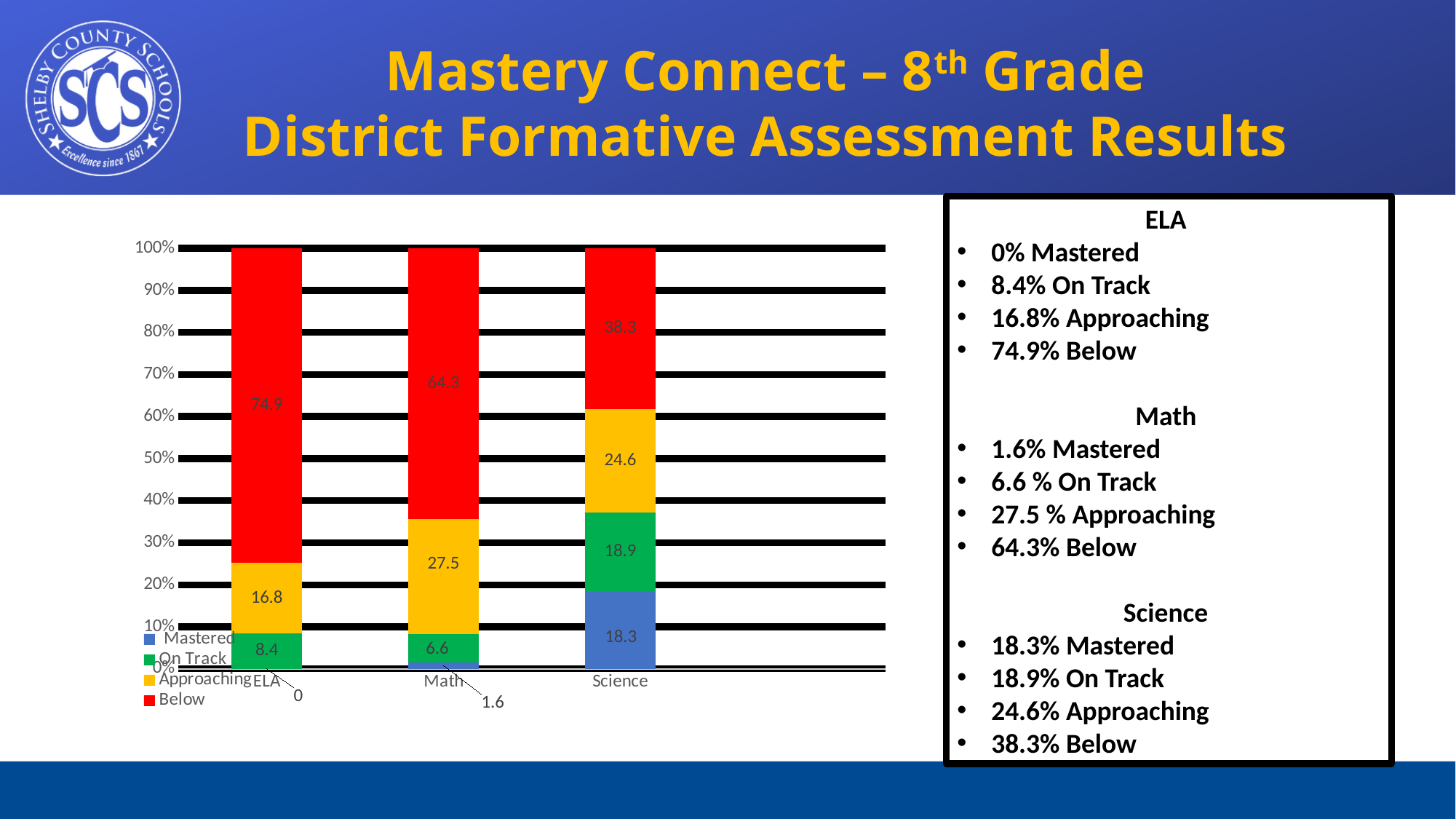
What is the Approaching value for Math in the chart? 27.5 Which subject has the highest Below value in the chart? ELA How many series does the chart legend list? 4 What is the Mastered value for Science in the chart? 18.3 Which subject has the lowest Mastered value in the chart? ELA What is the Below value for ELA in the chart? 74.9 What is the difference between the Below values for ELA and Science? 36.6 How many subjects are shown on the x axis of the chart? 3 Which is larger, the On Track value for ELA or the On Track value for Math? ELA What kind of chart is shown on the slide? Stacked bar chart Which colour represents the Below series in the chart? Red What is the Mastered value for Math in the chart? 1.6